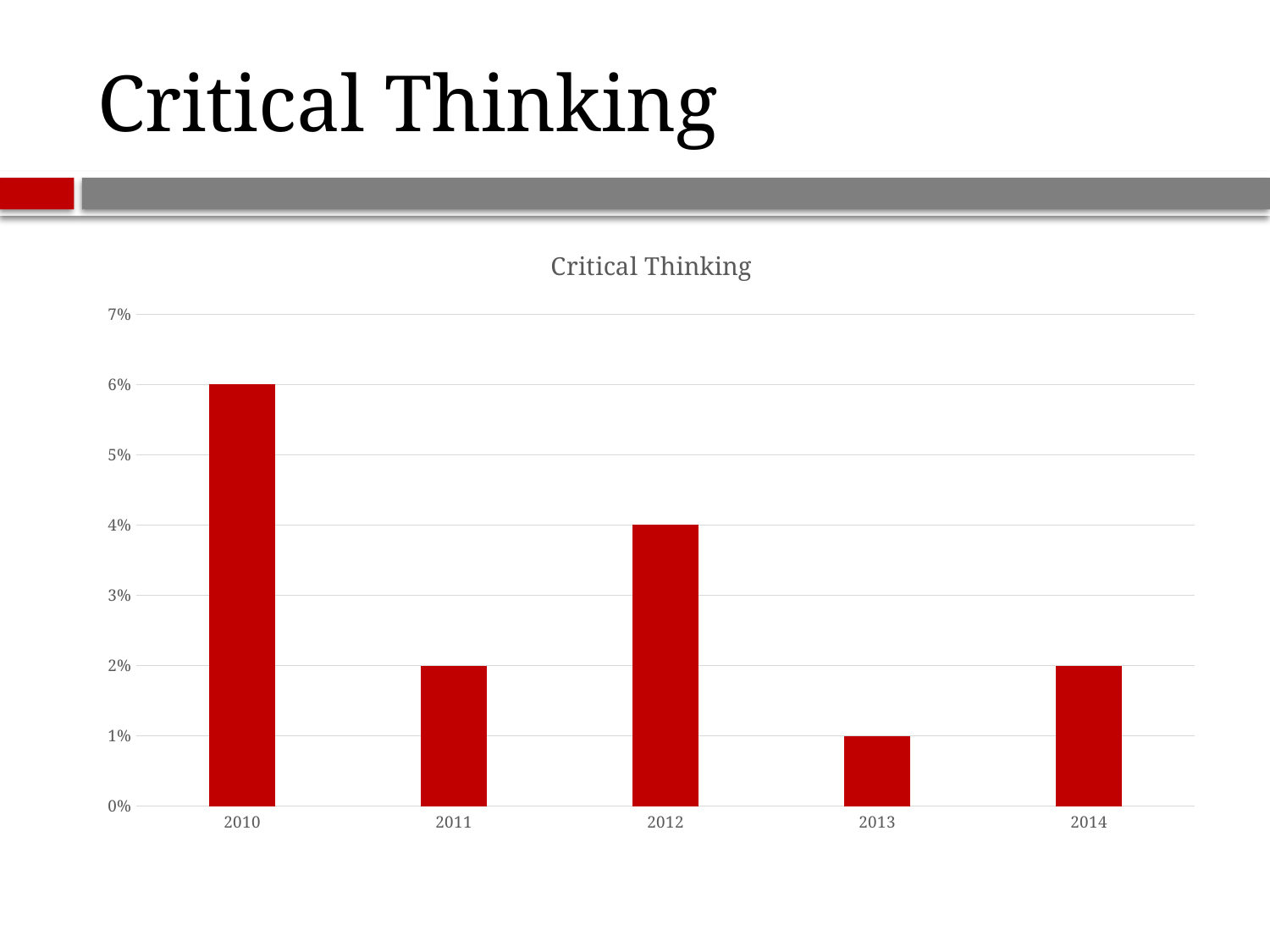
Which year has the highest value? 2010 What is the title of the chart? Critical Thinking What is the value for 2010? 6% Is the value for 2010 greater or less than 5%? greater What is the difference between the values for 2011 and 2013? 1% Which is larger, the value for 2012 or the value for 2014? 2012 What is the difference between the values for 2010 and 2012? 2% What is the value for 2013? 1% Which year has the lowest value? 2013 How many years are shown on the x axis? 5 What kind of chart is shown on the slide? bar chart What is the value for 2012? 4%